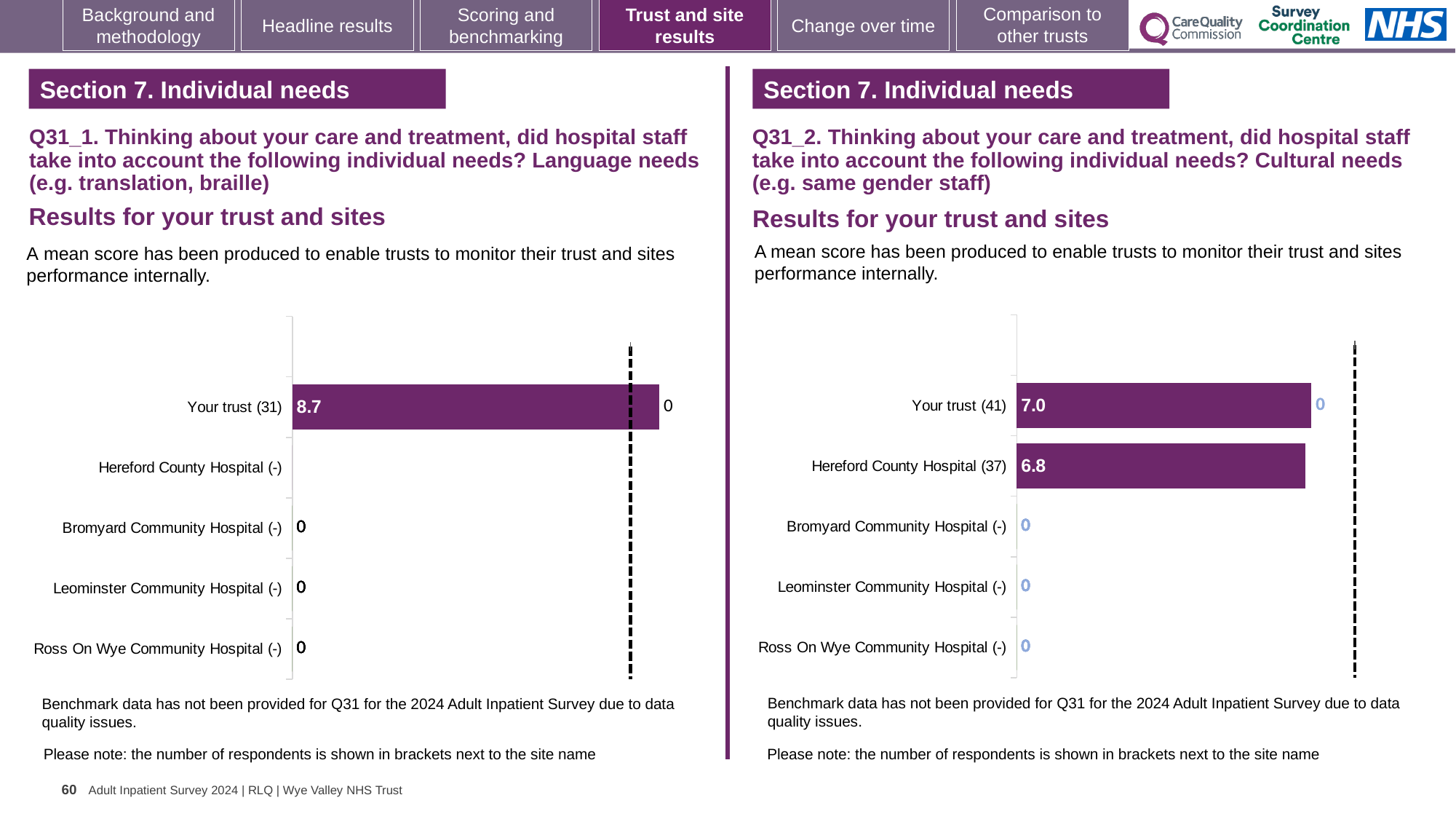
On the right chart (Q31_2, Cultural needs), what is the difference between the scores for Your trust and Hereford County Hospital? 0.2 On the right chart (Q31_2, Cultural needs), what is the mean score for Hereford County Hospital? 6.8 On the right chart (Q31_2, Cultural needs), how many respondents are shown in brackets for Hereford County Hospital? 37 On the right chart (Q31_2, Cultural needs), what is the mean score for Your trust? 7.0 On the right chart (Q31_2, Cultural needs), which has the higher score: Your trust or Hereford County Hospital? Your trust On the left chart (Q31_1, Language needs), which category has the highest plotted mean score? Your trust On the right chart (Q31_2, Cultural needs), which site has the lowest plotted mean score? Hereford County Hospital How many site categories are listed on the left chart (Q31_1, Language needs)? 5 On the left chart (Q31_1, Language needs), what is the mean score for Your trust? 8.7 How many site categories are listed on the right chart (Q31_2, Cultural needs)? 5 On the left chart (Q31_1, Language needs), how many respondents are shown in brackets for Your trust? 31 What kind of chart is shown on the left side of the slide (Q31_1)? Bar chart